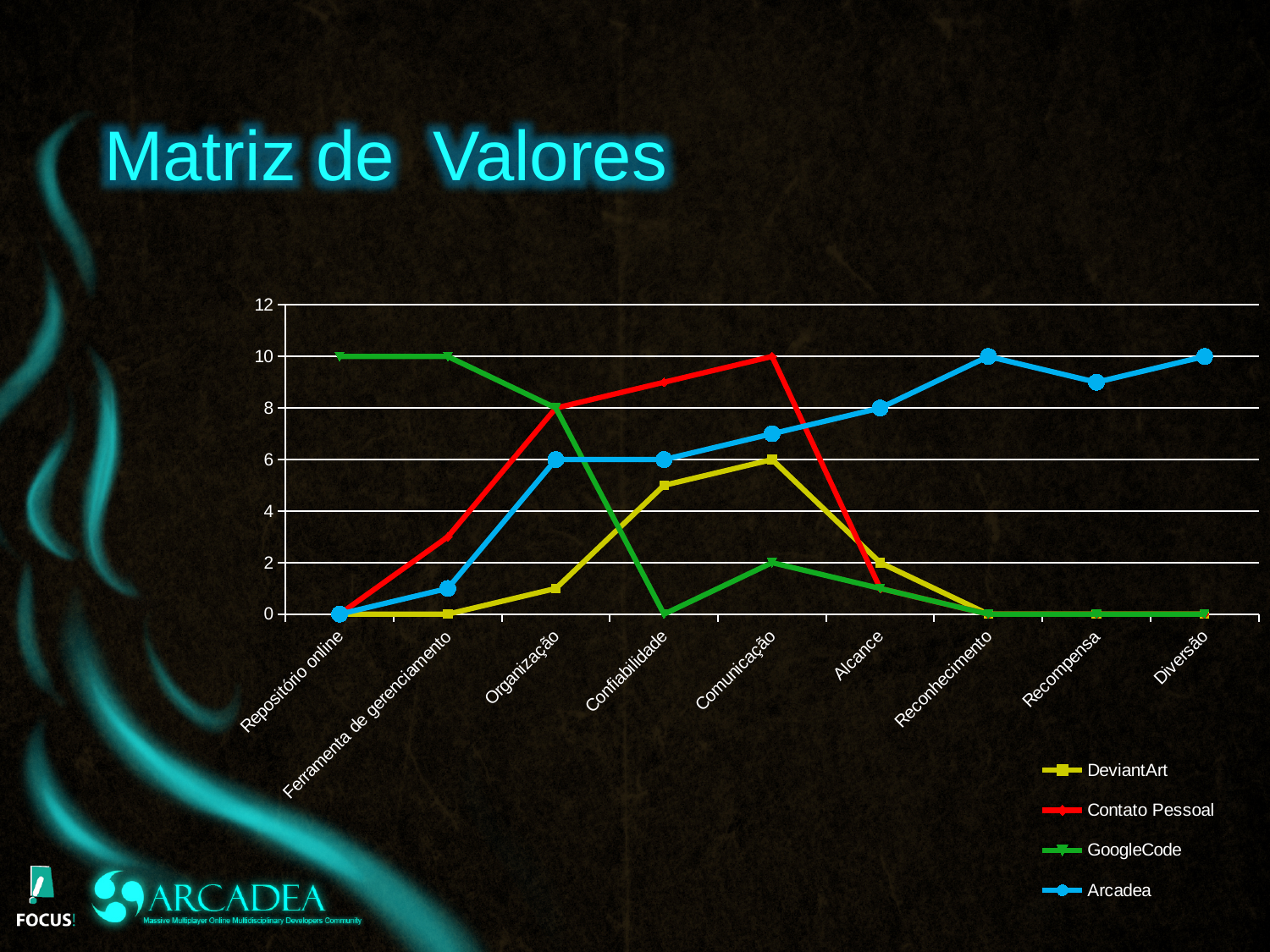
What is the value for DeviantArt at Comunicação? 6 What is the difference between Arcadea and DeviantArt at Alcance? 6 How many categories are shown on the x axis? 9 What type of chart is shown on the slide? Line chart What is the value for Arcadea at Reconhecimento? 10 How many series does the legend list? 4 At Organização, which is larger: Arcadea or GoogleCode? GoogleCode At which category does DeviantArt reach its highest value? Comunicação What is the title of the chart? Matriz de Valores What is the value for GoogleCode at Repositório online? 10 At which category does Contato Pessoal reach its highest value? Comunicação Is the value for Arcadea at Recompensa greater or less than 8? greater